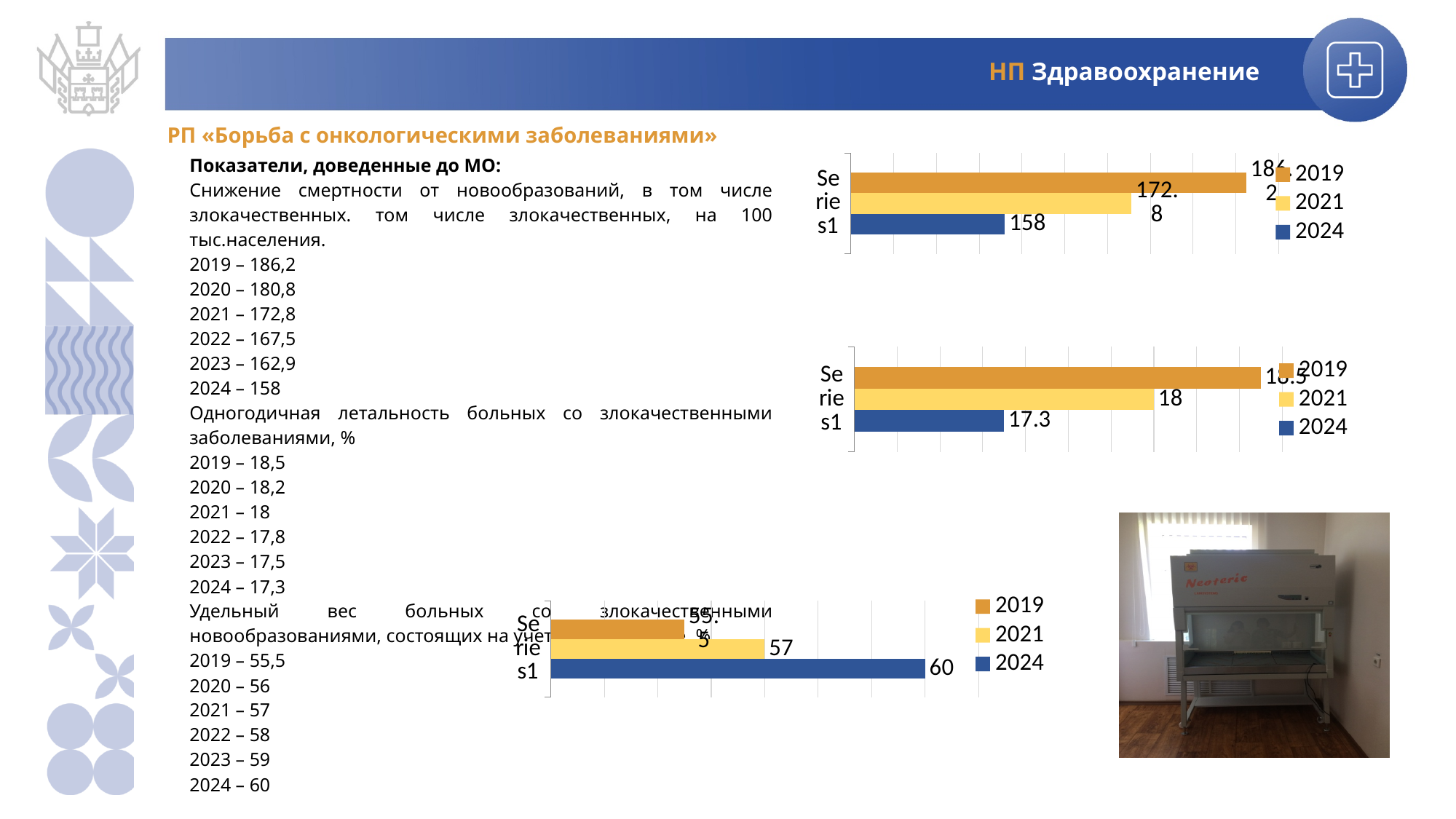
In the top chart, what is the value for 2024? 158 In the middle chart, what is the value for 2021? 18 In the bottom chart, which year has the highest value? 2024 In the middle chart, what is the value for 2024? 17.3 In the top chart, what is the value for 2021? 172.8 In the top chart, which year has the highest value? 2019 In the bottom chart, what is the value for 2024? 60 What kind of chart is the bottom chart? bar chart In the middle chart, which year has the lowest value? 2024 In the bottom chart, what is the difference between the values for 2024 and 2021? 3 In the bottom chart, what is the value for 2021? 57 How many series does the legend of the top chart list? 3